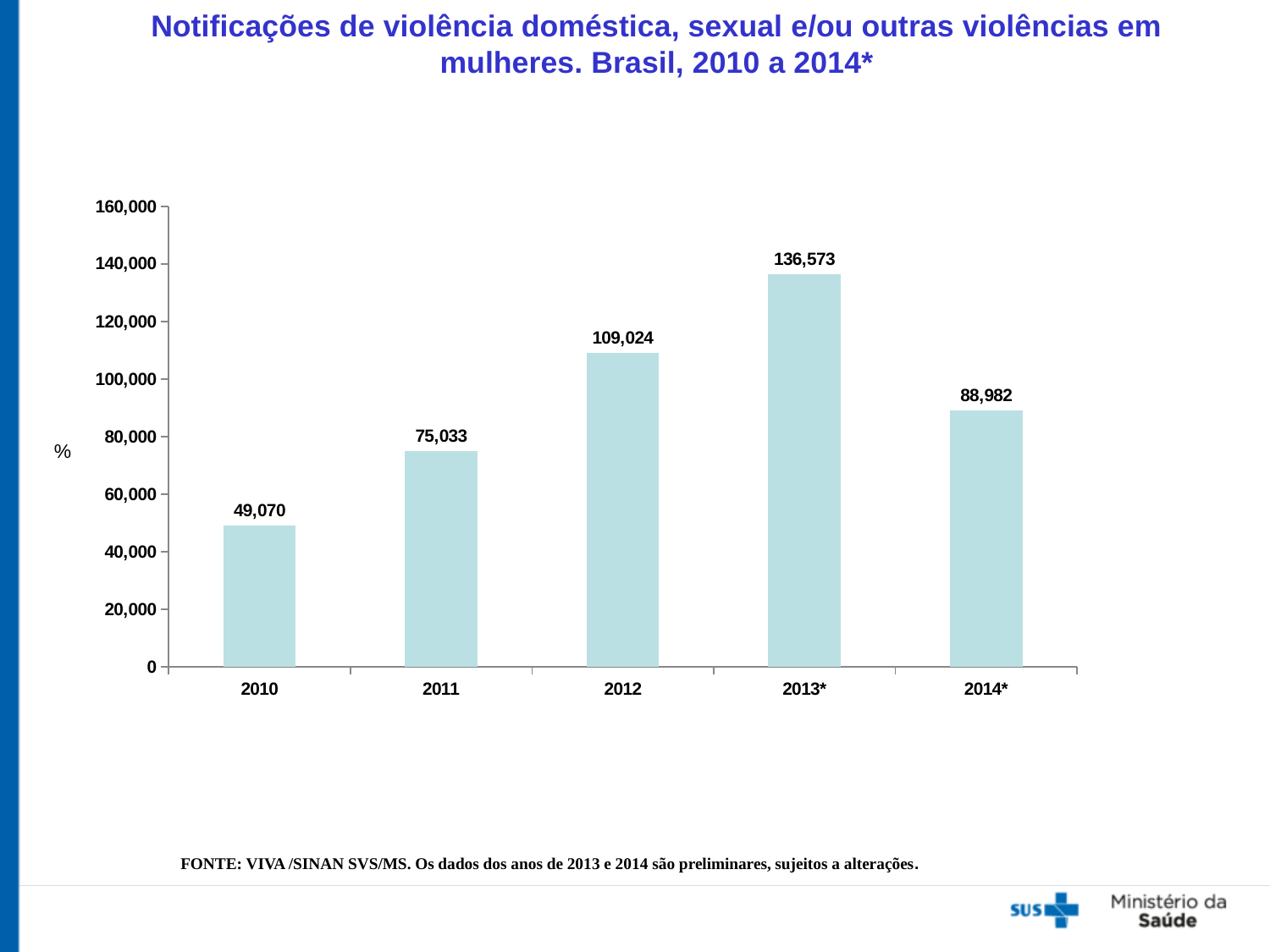
Which year has the lowest value? 2010 What is the value for 2012? 109,024 How many years are shown on the x axis? 5 Is the value for 2012 greater or less than 100,000? greater What is the value for 2014*? 88,982 Which is larger, the value for 2014* or the value for 2011? 2014* What is the difference between the values for 2011 and 2010? 25,963 Do the values rise or fall from 2010 to 2013*? rise Which year has the highest value? 2013* What kind of chart is shown on the slide? bar chart What is the difference between the values for 2013* and 2012? 27,549 What is the value for 2010? 49,070